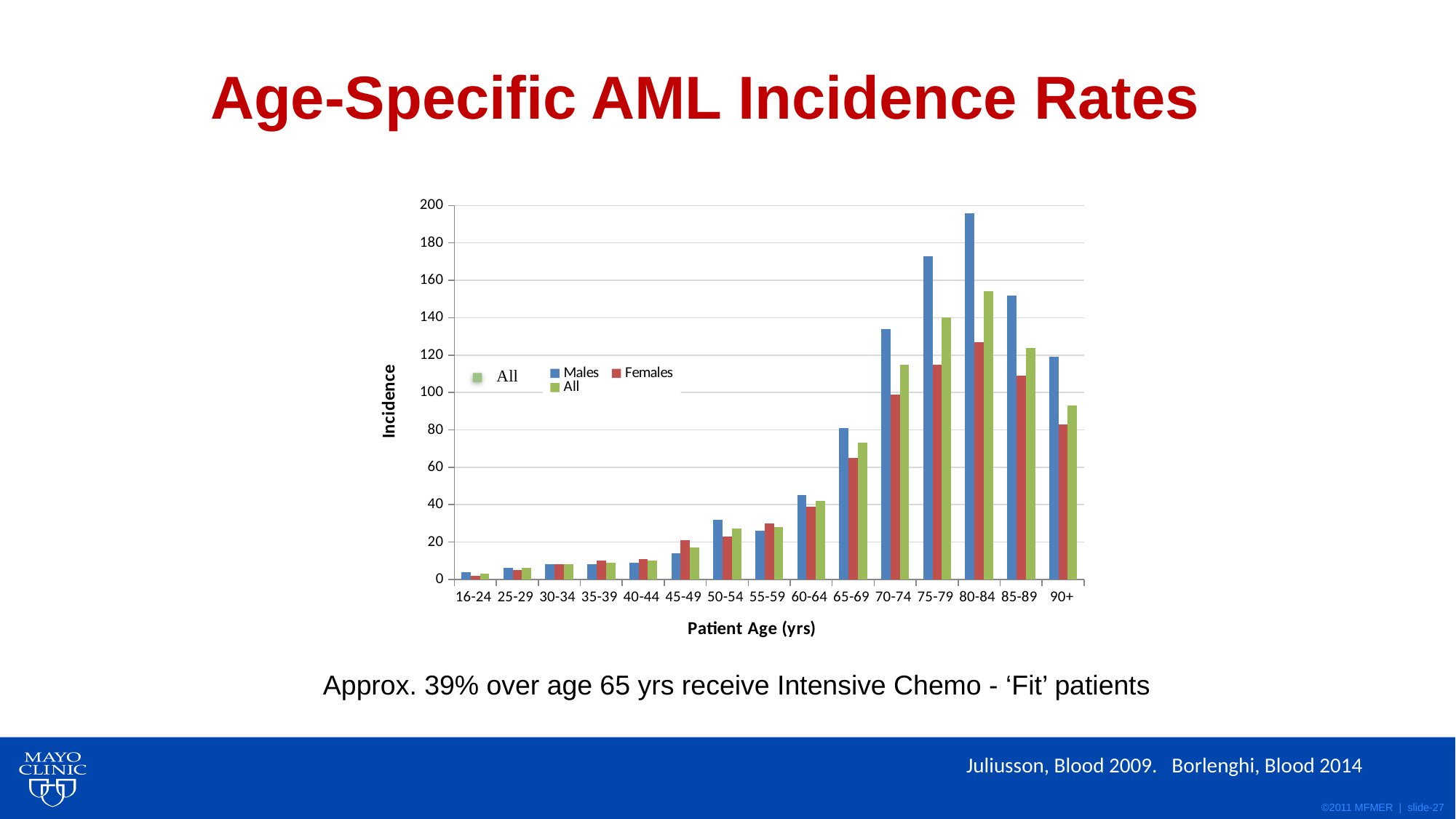
Which age group has the highest incidence for Females? 80-84 Do the Males values rise or fall from the 16-24 age group to the 80-84 age group? rise In the 45-49 age group, which is larger, the Males value or the Females value? Females What kind of chart is shown on the slide? bar chart In the 80-84 age group, which is larger, the Males value or the Females value? Males How many age categories are shown on the x axis? 15 Which age group has the highest incidence for Males? 80-84 Which age group has the lowest incidence for Males? 16-24 How many series does the chart legend list? 3 Is the Females value for the 90+ age group greater or less than 100? less Is the Males value for the 65-69 age group greater or less than 60? greater Is the Males value for the 80-84 age group greater or less than 180? greater